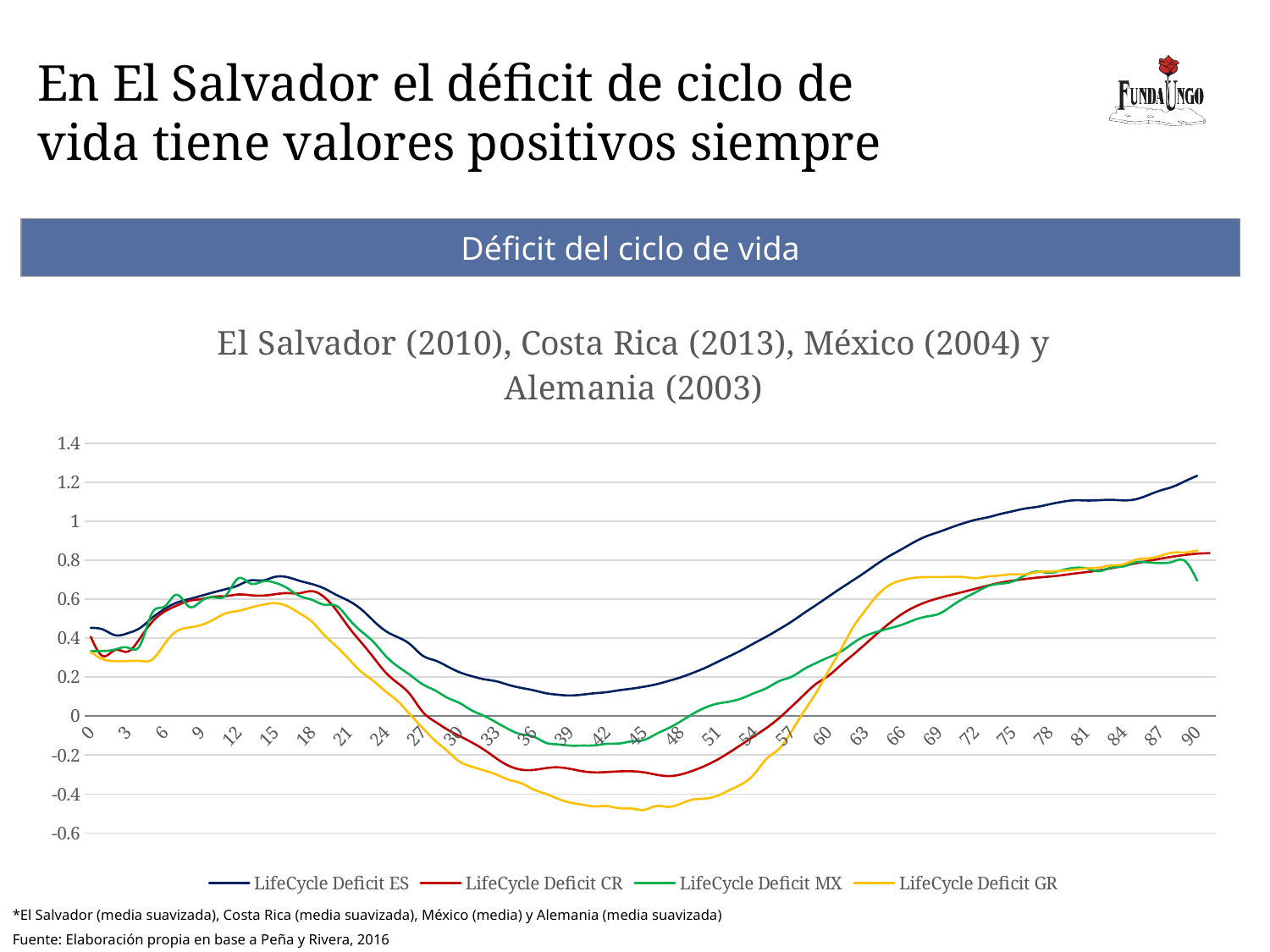
Is the value of LifeCycle Deficit MX at age 15 greater or less than 0.6? greater Is the value of LifeCycle Deficit ES at age 90 greater or less than 1? greater Which series has the lowest value at age 42? LifeCycle Deficit GR How many series does the legend list? 4 Which series has the highest value at age 60? LifeCycle Deficit ES Is the value of LifeCycle Deficit GR at age 42 greater or less than -0.4? less Which series never drops below 0 across the whole age range? LifeCycle Deficit ES At age 90, which is larger: LifeCycle Deficit ES or LifeCycle Deficit CR? LifeCycle Deficit ES What kind of chart is shown on the slide? line chart What are the four series named in the legend? LifeCycle Deficit ES, LifeCycle Deficit CR, LifeCycle Deficit MX, LifeCycle Deficit GR Does LifeCycle Deficit ES rise or fall between age 39 and age 90? rise